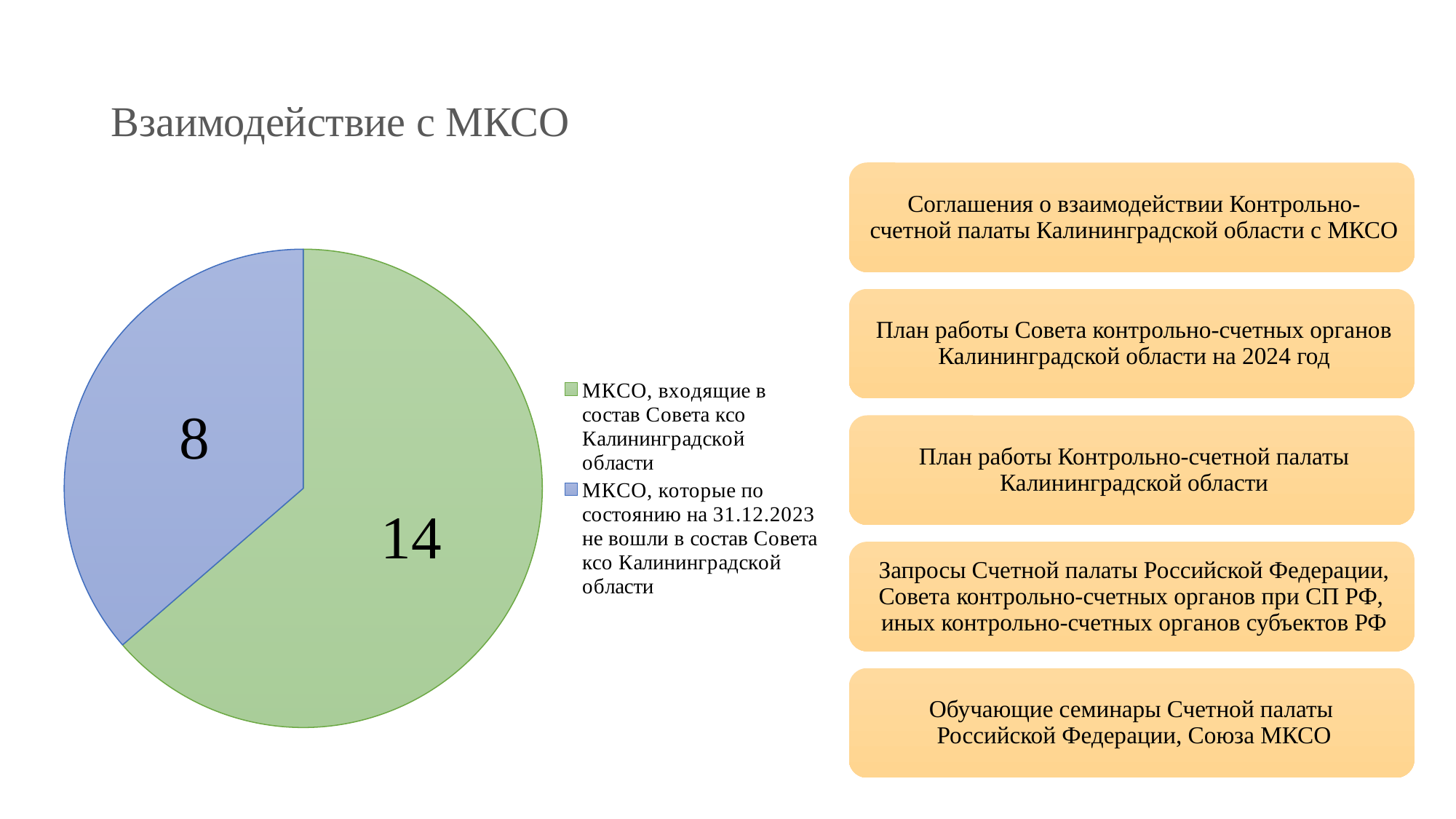
How many entries does the legend of the pie chart list? 2 What is the value of the slice for МКСО, входящие в состав Совета ксо Калининградской области? 14 What is the total of the two slices in the pie chart? 22 Which is larger: the number of МКСО in the Council (green) or the number not in the Council (blue)? МКСО in the Council (green), 14 What type of chart is shown on the slide? pie chart How many slices does the pie chart have? 2 What is the difference between the number of МКСО in the Council and the number not in the Council? 6 Which slice of the pie chart is the smallest? МКСО, которые по состоянию на 31.12.2023 не вошли в состав Совета ксо Калининградской области What colour is the slice for МКСО that had not joined the Council as of 31.12.2023? blue What is the value of the slice for МКСО, которые по состоянию на 31.12.2023 не вошли в состав Совета ксо Калининградской области? 8 What share of the pie does the slice with value 14 represent? 14 of 22 (63.6%) Which slice of the pie chart is the largest? МКСО, входящие в состав Совета ксо Калининградской области